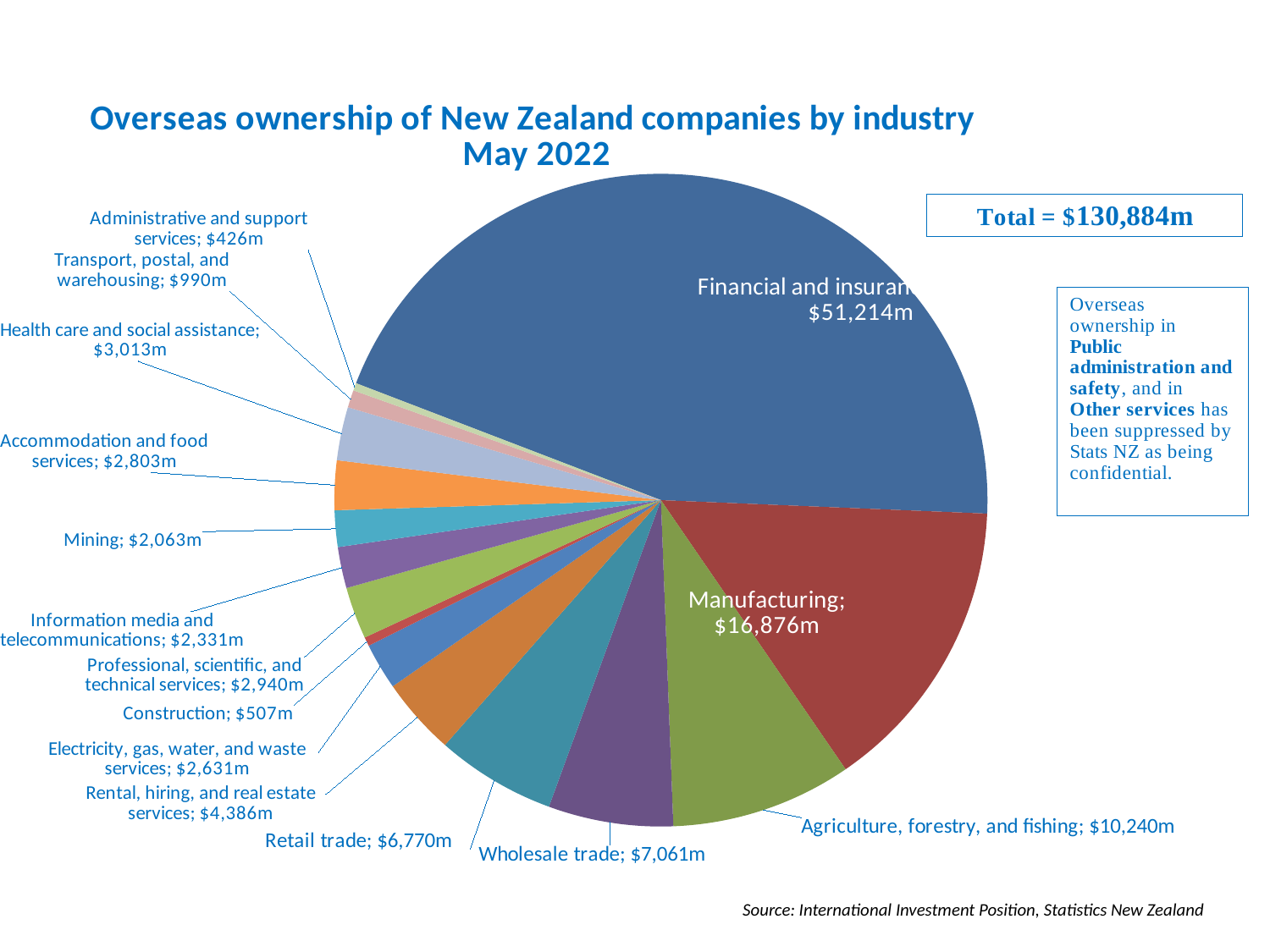
What is the value for Agriculture, forestry, and fishing? $10,240m What is the title of the chart? Overseas ownership of New Zealand companies by industry May 2022 What type of chart is shown on the slide? Pie chart What is the value for Manufacturing? $16,876m Which is larger, Health care and social assistance or Professional, scientific, and technical services? Health care and social assistance What is the value for Construction? $507m Which industry has the smallest value shown? Administrative and support services What is the value for Rental, hiring, and real estate services? $4,386m What is the difference between Wholesale trade and Retail trade? $291m What is the difference between Manufacturing and Agriculture, forestry, and fishing? $6,636m What total value is shown for the pie chart? $130,884m Which industry has the largest slice of the pie? Financial and insurance